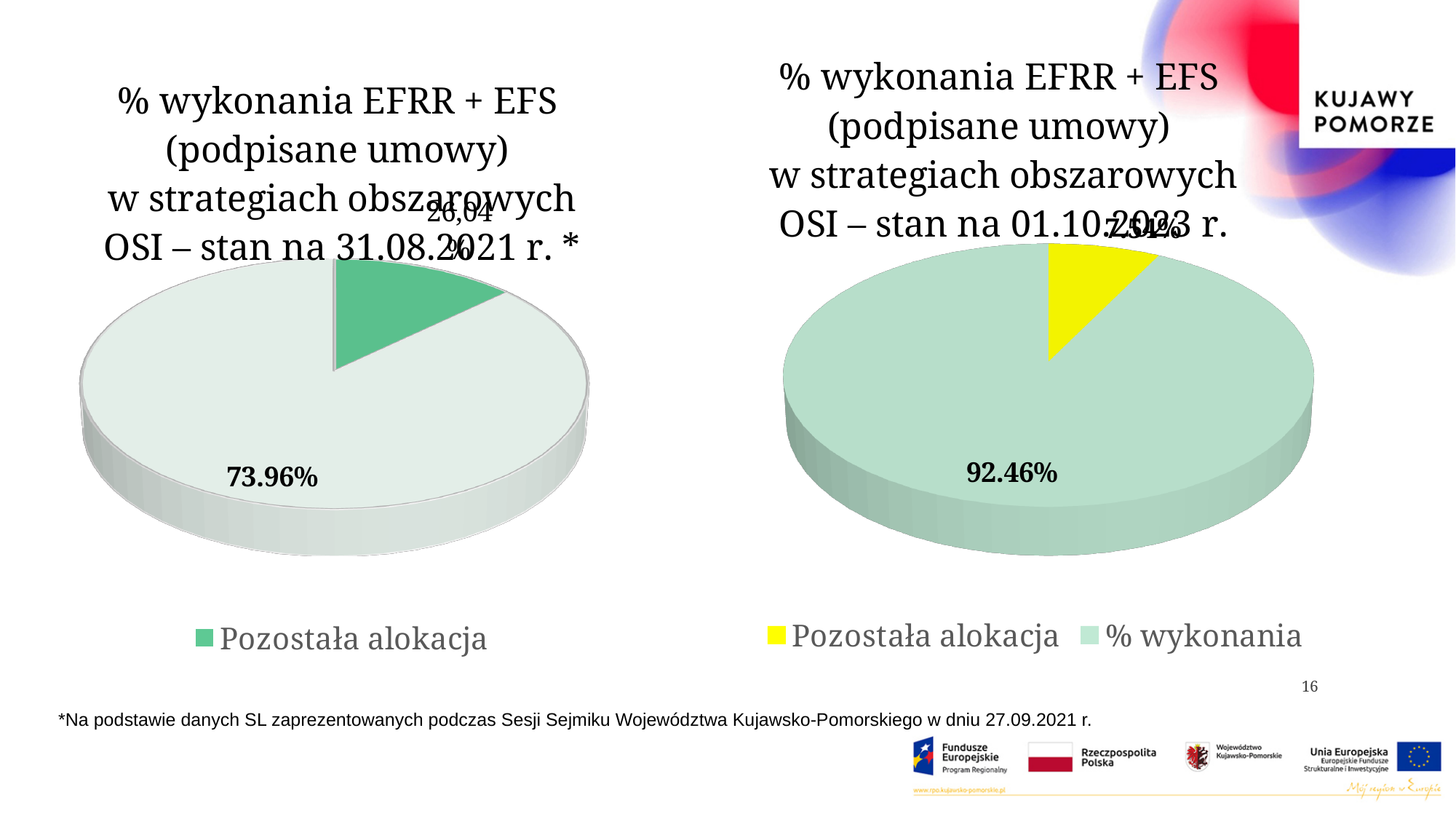
In the left chart (stan na 31.08.2021 r.), what value is printed on the largest slice? 73.96% In the right chart (stan na 01.10.2023 r.), which slice is larger: 'Pozostała alokacja' or '% wykonania'? % wykonania Which chart has the larger value printed on its largest slice: the left chart (31.08.2021) or the right chart (01.10.2023)? the right chart (01.10.2023) What kind of chart is shown on the left side of the slide? pie chart In the right chart (stan na 01.10.2023 r.), what value is printed on the largest slice? 92.46% What kind of chart is shown on the right side of the slide? pie chart How many entries does the legend of the right chart (stan na 01.10.2023 r.) list? 2 What is the difference between the largest slice value in the right chart (92.46%) and the largest slice value in the left chart (73.96%)? 18.50 percentage points In the right chart (stan na 01.10.2023 r.), what colour is the 'Pozostała alokacja' slice? yellow In the right chart (stan na 01.10.2023 r.), what is the value for '% wykonania'? 92.46% How many entries does the legend of the left chart (stan na 31.08.2021 r.) list? 1 What date is given in the title of the right chart? 01.10.2023 r.